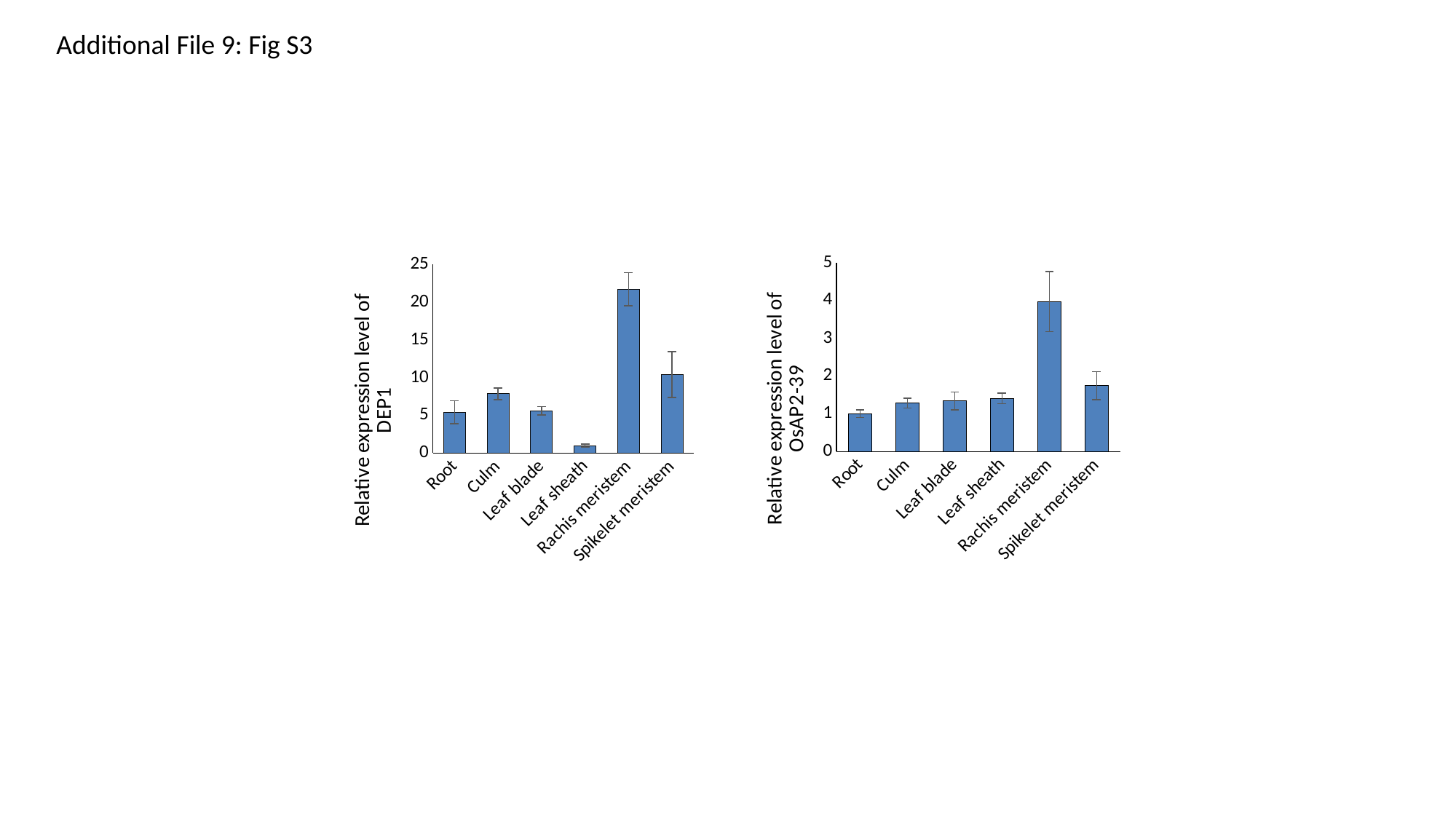
In the right chart (OsAP2-39), is the value for Rachis meristem greater or less than 3? greater In the left chart (DEP1), which tissue has the lowest relative expression level? Leaf sheath In the right chart (OsAP2-39), which tissue has the lowest relative expression level? Root In the right chart (OsAP2-39), is the value for Spikelet meristem greater or less than 2? less What kind of chart is the right chart (OsAP2-39)? bar chart In the right chart (OsAP2-39), which tissue has the highest relative expression level? Rachis meristem In the left chart (DEP1), is the value for Spikelet meristem greater or less than 15? less In the right chart (OsAP2-39), which is larger, the value for Spikelet meristem or the value for Root? Spikelet meristem How many tissue categories are shown on the x axis of the left chart (DEP1)? 6 In the left chart (DEP1), which tissue has the highest relative expression level? Rachis meristem In the left chart (DEP1), which is larger, the value for Culm or the value for Leaf sheath? Culm